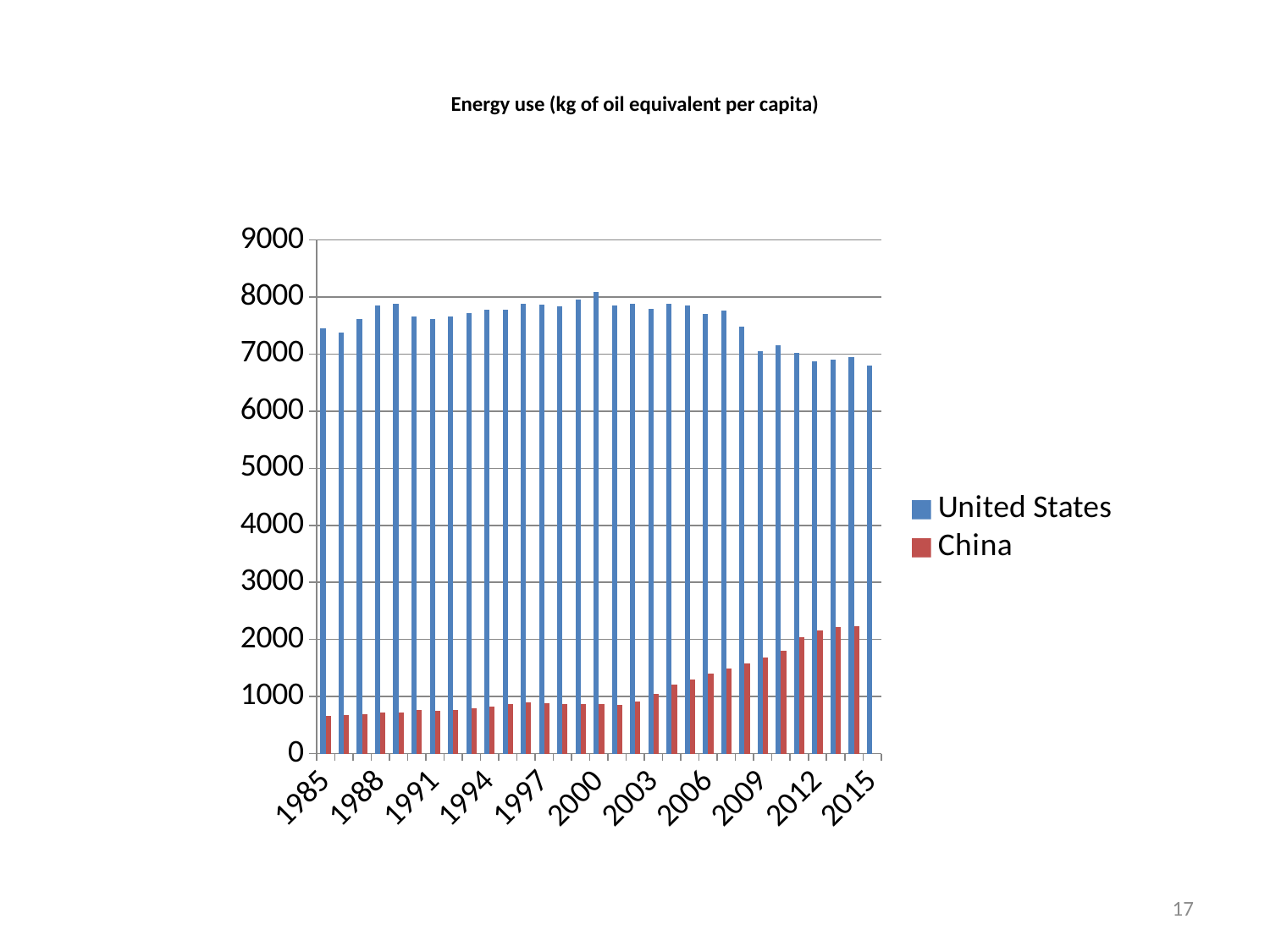
Do the values for China rise or fall from 1985 to 2015? rise What kind of chart is shown on the slide? bar chart What is the title of the chart? Energy use (kg of oil equivalent per capita) In which year is the United States value highest? 2000 Is the value for China in 1985 greater or less than 1000? less Is the value for the United States in 2015 greater or less than 7000? less Do the values for the United States rise or fall from 2000 to 2015? fall Is the value for the United States in 1985 greater or less than 7000? greater How many series does the legend list? 2 Which series is shown in red? China